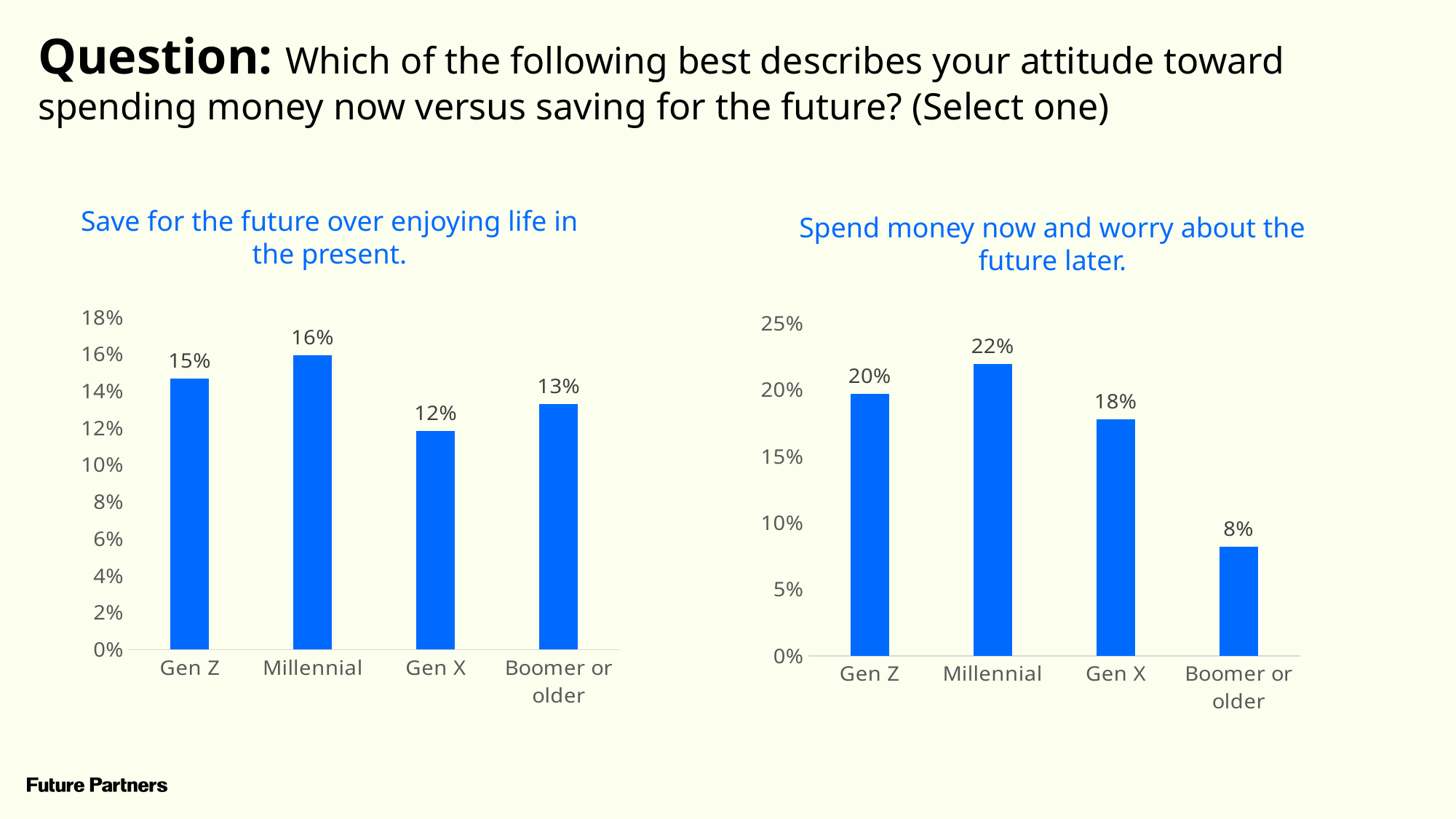
In the 'Save for the future over enjoying life in the present.' chart, what is the difference between the Gen Z and Boomer or older values? 2% In the 'Save for the future over enjoying life in the present.' chart, is the value for Gen Z greater or less than 14%? greater In the 'Spend money now and worry about the future later.' chart, which category has the highest value? Millennial In the 'Spend money now and worry about the future later.' chart, how many categories are shown on the x axis? 4 In the 'Spend money now and worry about the future later.' chart, what is the difference between the Millennial and Gen X values? 4% In the 'Spend money now and worry about the future later.' chart, do the values rise or fall from Millennial to Boomer or older? Fall In the 'Spend money now and worry about the future later.' chart, what is the value for Boomer or older? 8% What is the title of the chart on the right side of the slide? Spend money now and worry about the future later. In the 'Spend money now and worry about the future later.' chart, which is larger, the value for Gen Z or the value for Gen X? Gen Z In the 'Save for the future over enjoying life in the present.' chart, what is the value for Millennial? 16% What kind of chart is the 'Save for the future over enjoying life in the present.' chart? Bar chart In the 'Save for the future over enjoying life in the present.' chart, which category has the lowest value? Gen X